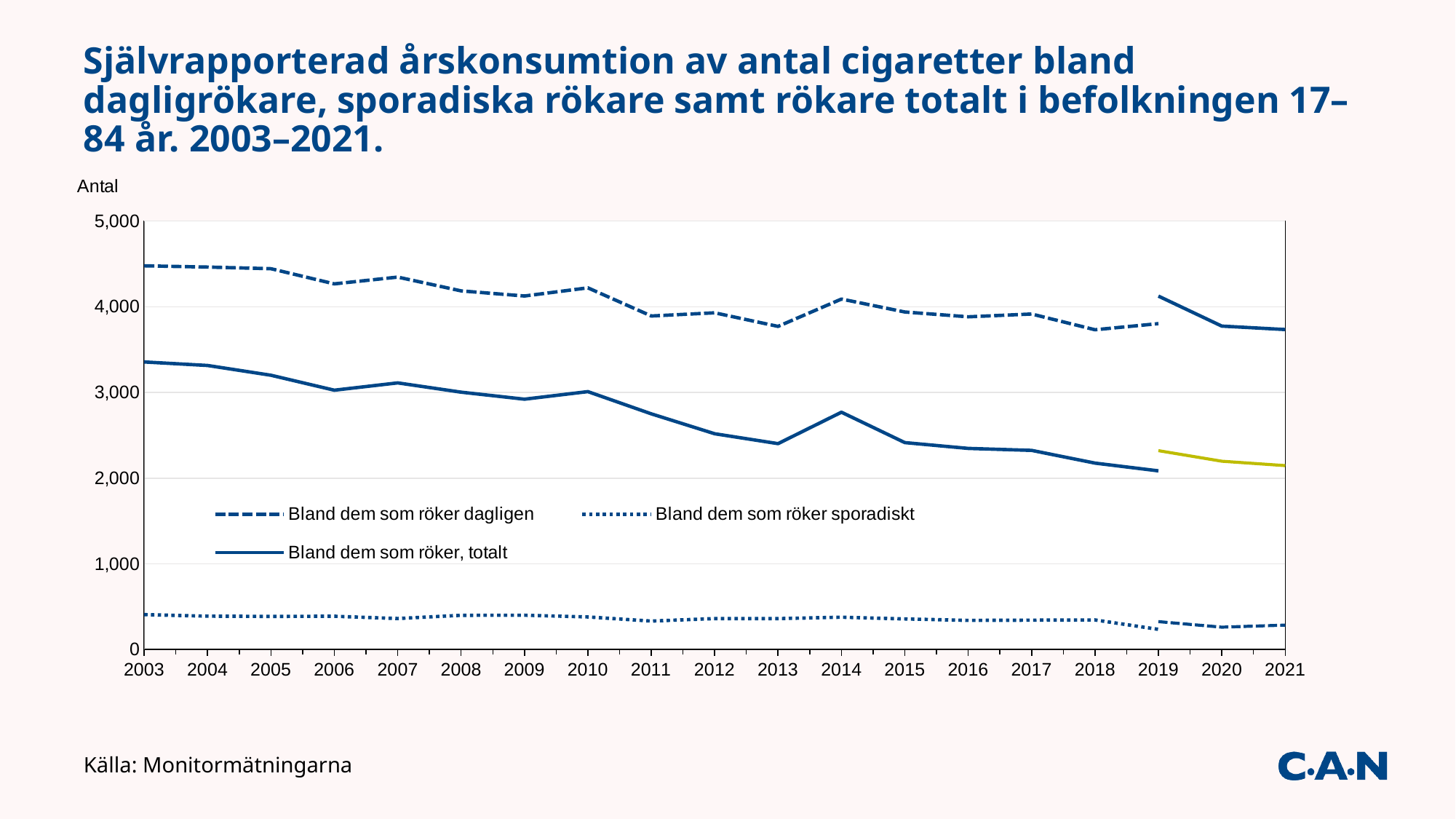
Is the value for 'Bland dem som röker dagligen' in 2003 greater or less than 4,000? greater Which series has the highest values throughout the chart? Bland dem som röker dagligen Does the 'Bland dem som röker, totalt' series generally rise or fall from 2003 to 2019? fall How many years are shown on the x axis? 19 Is the value for 'Bland dem som röker, totalt' in 2003 greater or less than 3,000? greater Is the value for 'Bland dem som röker dagligen' in 2013 greater or less than 4,000? less For 'Bland dem som röker, totalt', which year has the larger value, 2013 or 2014? 2014 What kind of chart is shown on the slide? line chart Which series has the lowest values throughout the chart? Bland dem som röker sporadiskt How many series does the legend list? 3